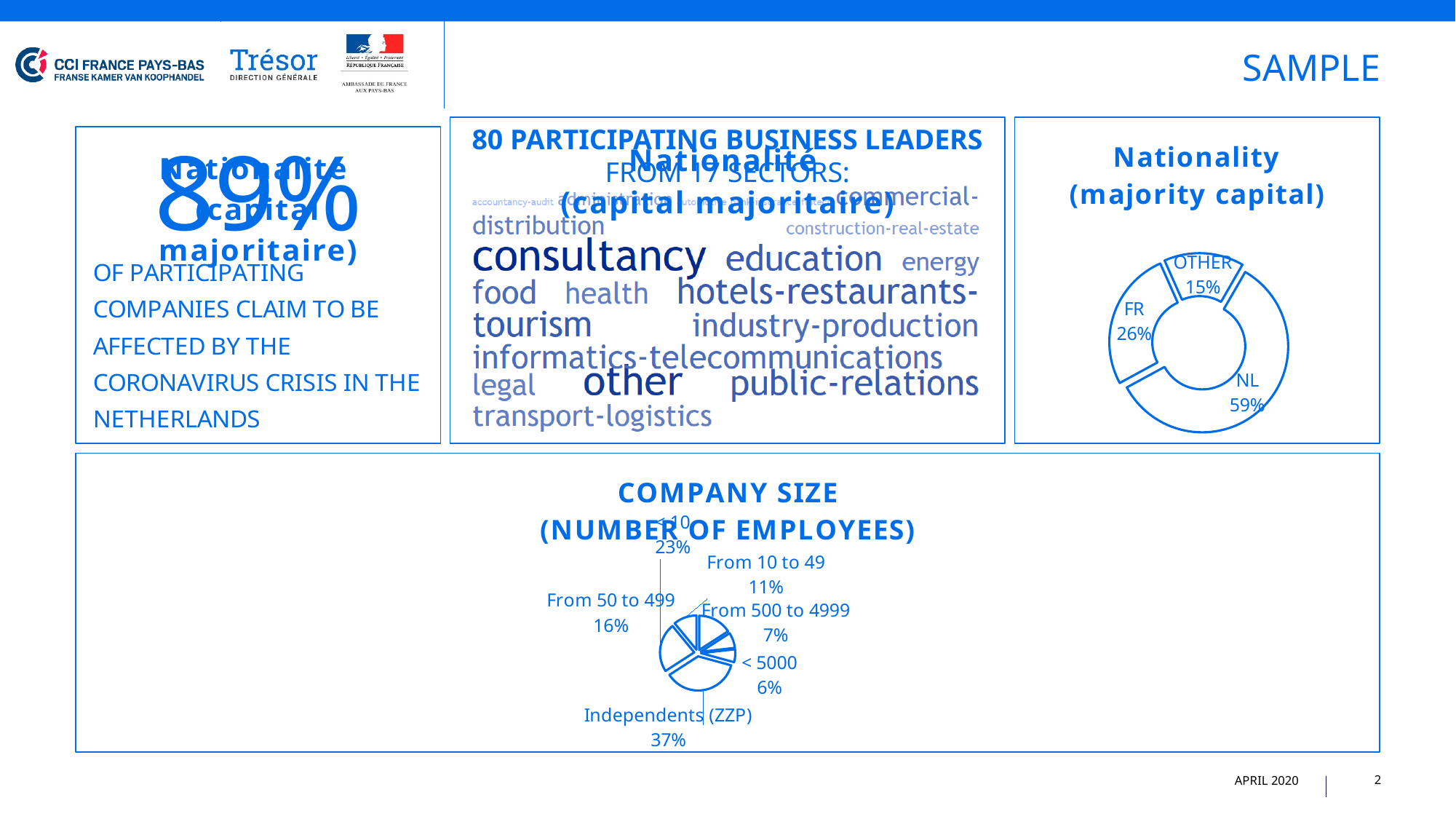
In the Company Size chart, which is larger: From 10 to 49 or From 500 to 4999? From 10 to 49 In the Nationality (majority capital) chart, what is the difference between the NL and FR shares? 33 percentage points In the Company Size chart, what share is From 50 to 499? 16% In the Company Size chart, which category has the largest share? Independents (ZZP) What kind of chart is the Nationality (majority capital) chart? Doughnut chart What kind of chart is the Company Size chart? Pie chart In the Company Size chart, what share is Independents (ZZP)? 37% How many categories does the Nationality (majority capital) chart show? 3 In the Nationality (majority capital) chart, which category has the smallest share? OTHER How many categories does the Company Size chart show? 6 In the Nationality (majority capital) chart, what share is FR? 26% In the Nationality (majority capital) chart, what share is NL? 59%